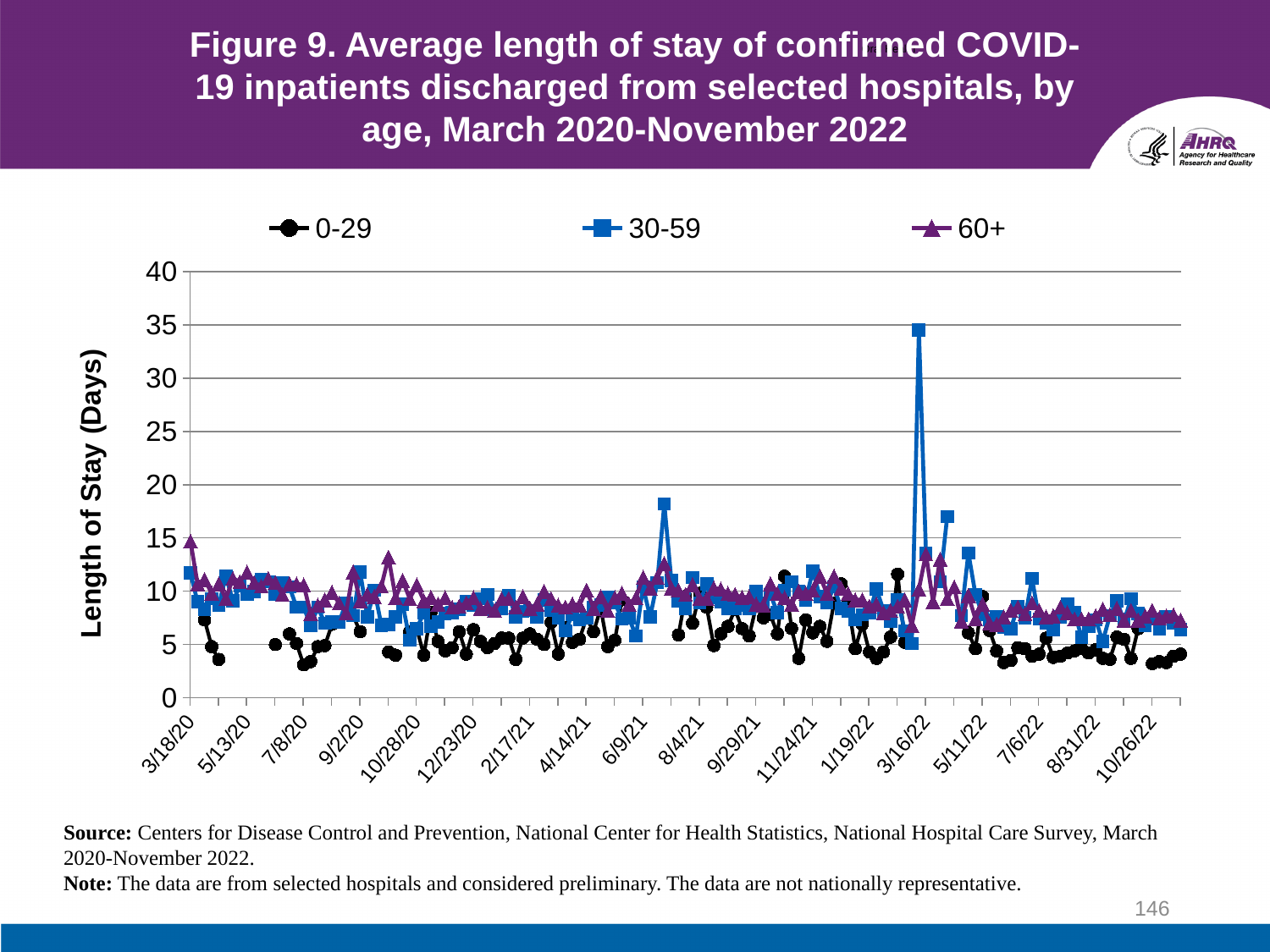
What is the label on the vertical axis? Length of Stay (Days) Is the value for the 60+ series at 3/18/20 greater or less than 10? greater Does the 0-29 series overall rise or fall from 3/18/20 to 10/26/22? fall Which series reaches the highest single value on the chart? 30-59 Is the highest value reached by the 30-59 series greater or less than 30? greater Which series generally has the lowest values across the period? 0-29 Is the value for the 0-29 series at 10/26/22 greater or less than 5? less How many series does the legend list? 3 What kind of chart is shown on the slide? line chart What are the three age groups listed in the legend? 0-29, 30-59, 60+